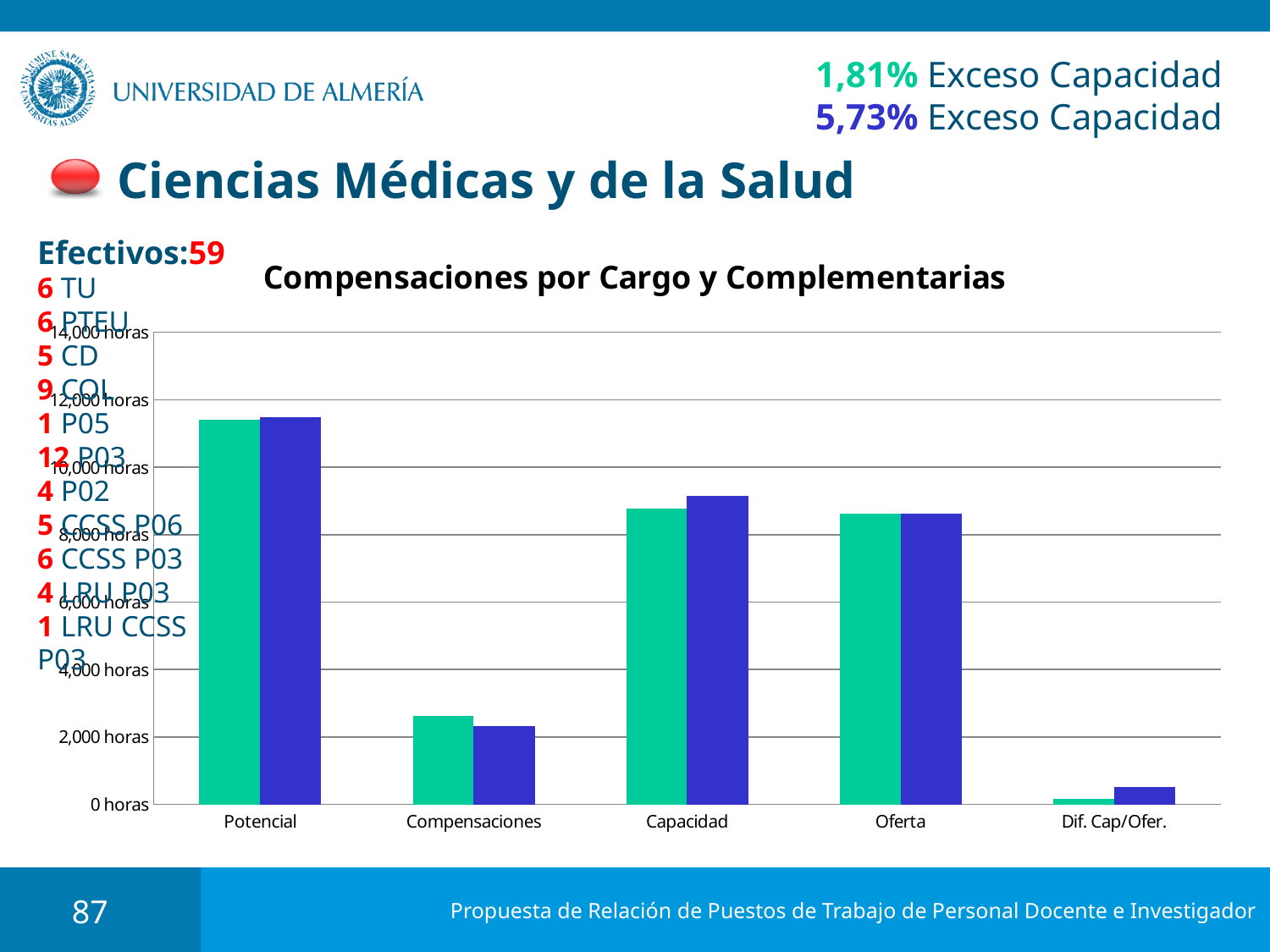
Which category has the tallest bars in the chart? Potencial What kind of chart is shown on the slide? bar chart Which category has a larger value: Compensaciones or Capacidad? Capacidad What unit is shown on the y axis of the chart? horas Which category has a larger value: Potencial or Oferta? Potencial Is the value of the green bar for Potencial greater or less than 10,000 horas? greater Is the value of the green bar for Compensaciones greater or less than 4,000 horas? less How many categories are shown on the x axis of the chart? 5 Is the value of the blue bar for Dif. Cap/Ofer. greater or less than 2,000 horas? less What is the title of the chart? Compensaciones por Cargo y Complementarias Which category has the shortest bars in the chart? Dif. Cap/Ofer.